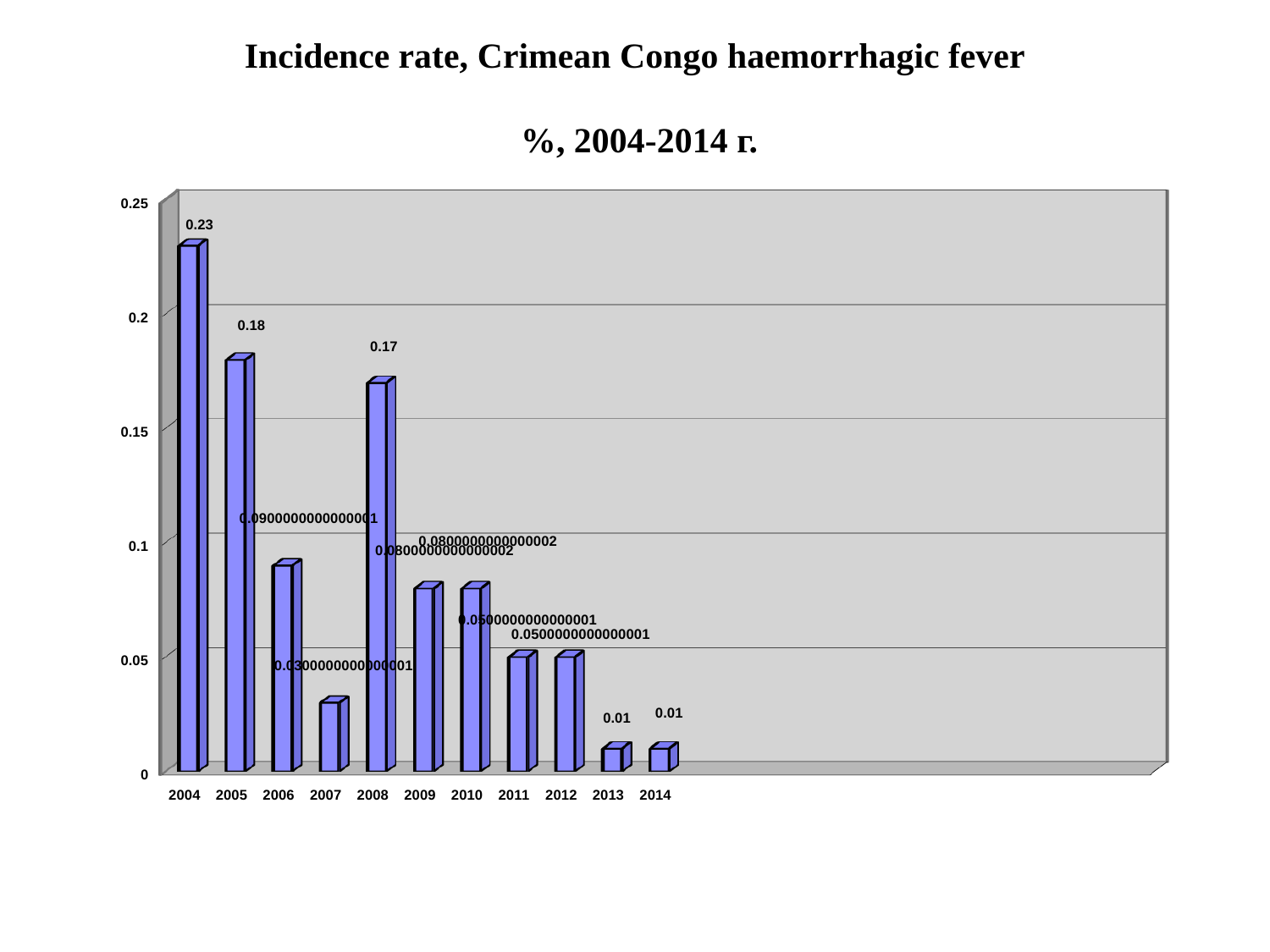
What is the difference between the incidence rates for 2004 and 2008? 0.06 How many years are shown on the x axis? 11 What type of chart is shown on the slide? bar chart What is the incidence rate for 2013? 0.01 What is the incidence rate for 2004? 0.23 What is the incidence rate for 2008? 0.17 Which year has a higher incidence rate, 2005 or 2008? 2005 What is the difference between the incidence rates for 2004 and 2005? 0.05 Which year has the highest incidence rate? 2004 Is the value for 2007 greater or less than 0.05? less Is the value for 2006 greater or less than 0.1? less What is the incidence rate for 2005? 0.18